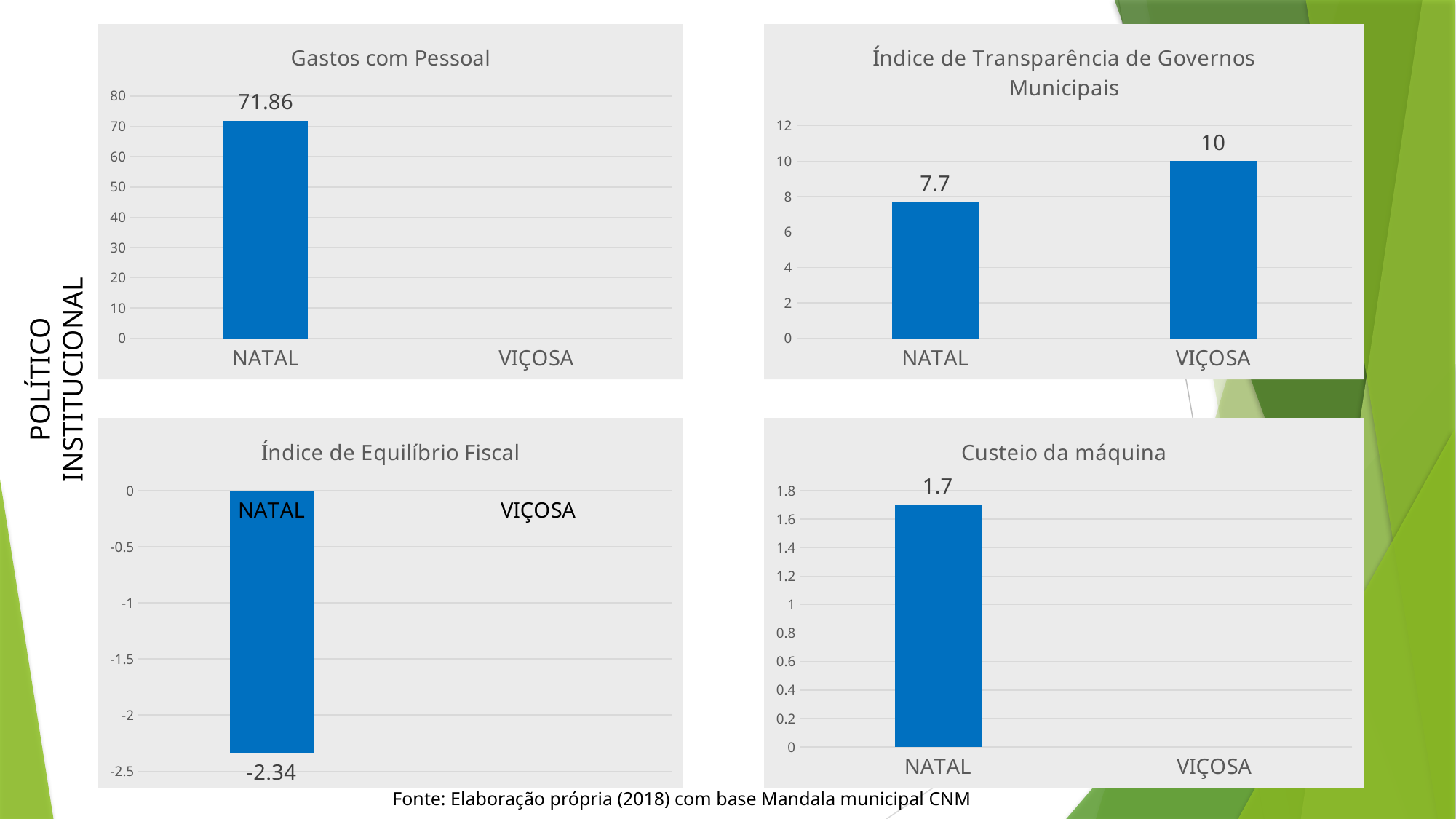
In the 'Índice de Transparência de Governos Municipais' chart, what is the value for NATAL? 7.7 What is the title of the chart in the top-right of the slide? Índice de Transparência de Governos Municipais In the 'Índice de Transparência de Governos Municipais' chart, is the value for NATAL larger or smaller than the value for VIÇOSA? smaller In the 'Índice de Transparência de Governos Municipais' chart, what is the value for VIÇOSA? 10 How many categories are shown on the x axis of the 'Custeio da máquina' chart? 2 In the 'Gastos com Pessoal' chart, what is the value for NATAL? 71.86 In the 'Gastos com Pessoal' chart, is the value for NATAL greater or less than 70? greater In the 'Índice de Transparência de Governos Municipais' chart, what is the difference between the values for VIÇOSA and NATAL? 2.3 In the 'Custeio da máquina' chart, what is the value for NATAL? 1.7 In the 'Índice de Equilíbrio Fiscal' chart, what is the value for NATAL? -2.34 What kind of chart is the 'Índice de Equilíbrio Fiscal' chart? bar chart In the 'Índice de Transparência de Governos Municipais' chart, which city has the higher value? VIÇOSA